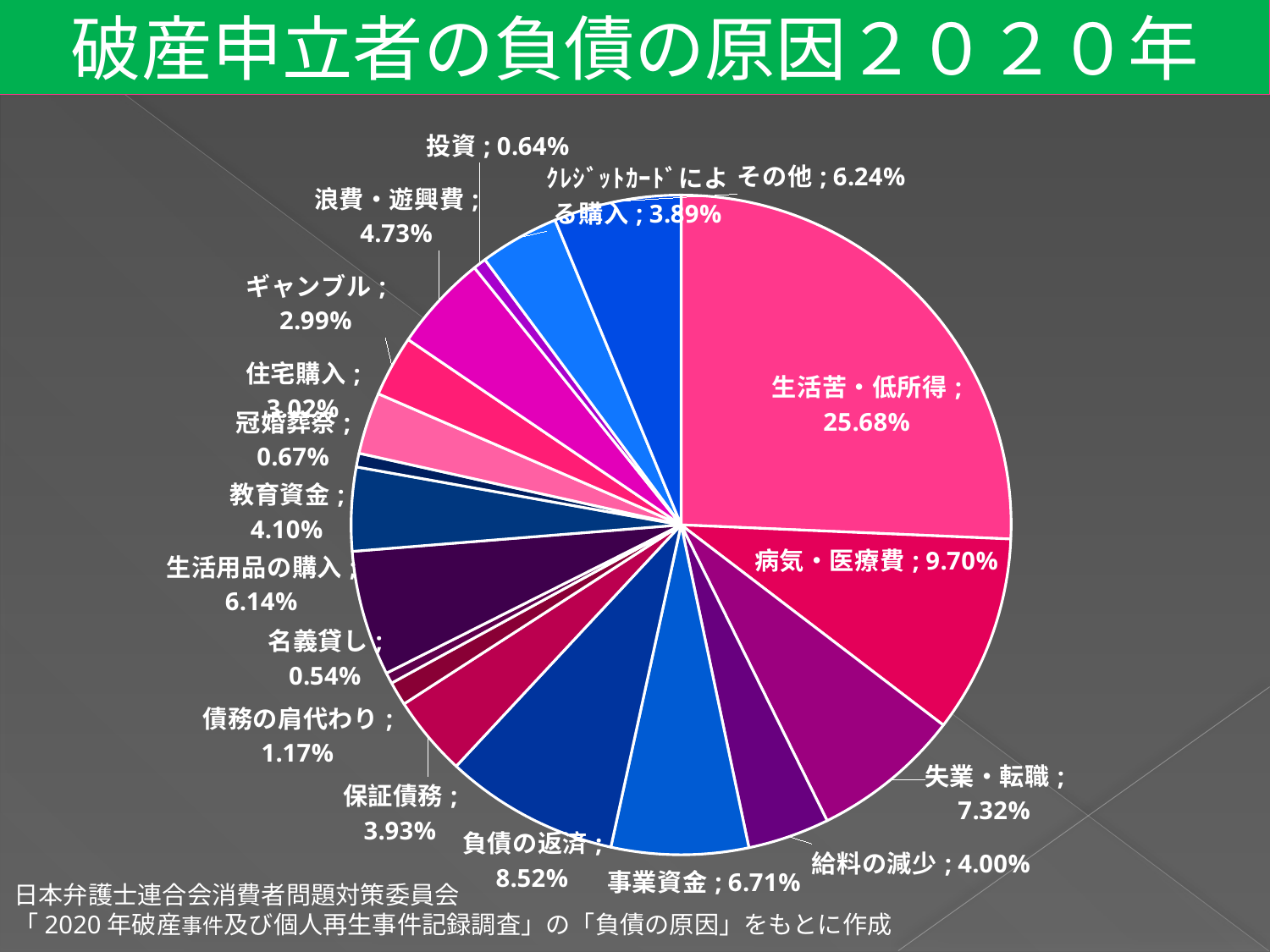
What is the difference between the shares for 失業・転職 and 給料の減少? 3.32% What is the title of the chart? 破産申立者の負債の原因２０２０年 What is the share for 教育資金? 4.10% What is the share for 負債の返済? 8.52% How many categories are shown in the pie chart? 18 Which is larger, the share for 事業資金 or the share for 生活用品の購入? 事業資金 What is the share for 生活苦・低所得? 25.68% Which category has the smallest share of the pie? 名義貸し Which category has the largest share of the pie? 生活苦・低所得 What is the share for その他? 6.24% What is the share for 病気・医療費? 9.70% What kind of chart is shown on the slide? pie chart